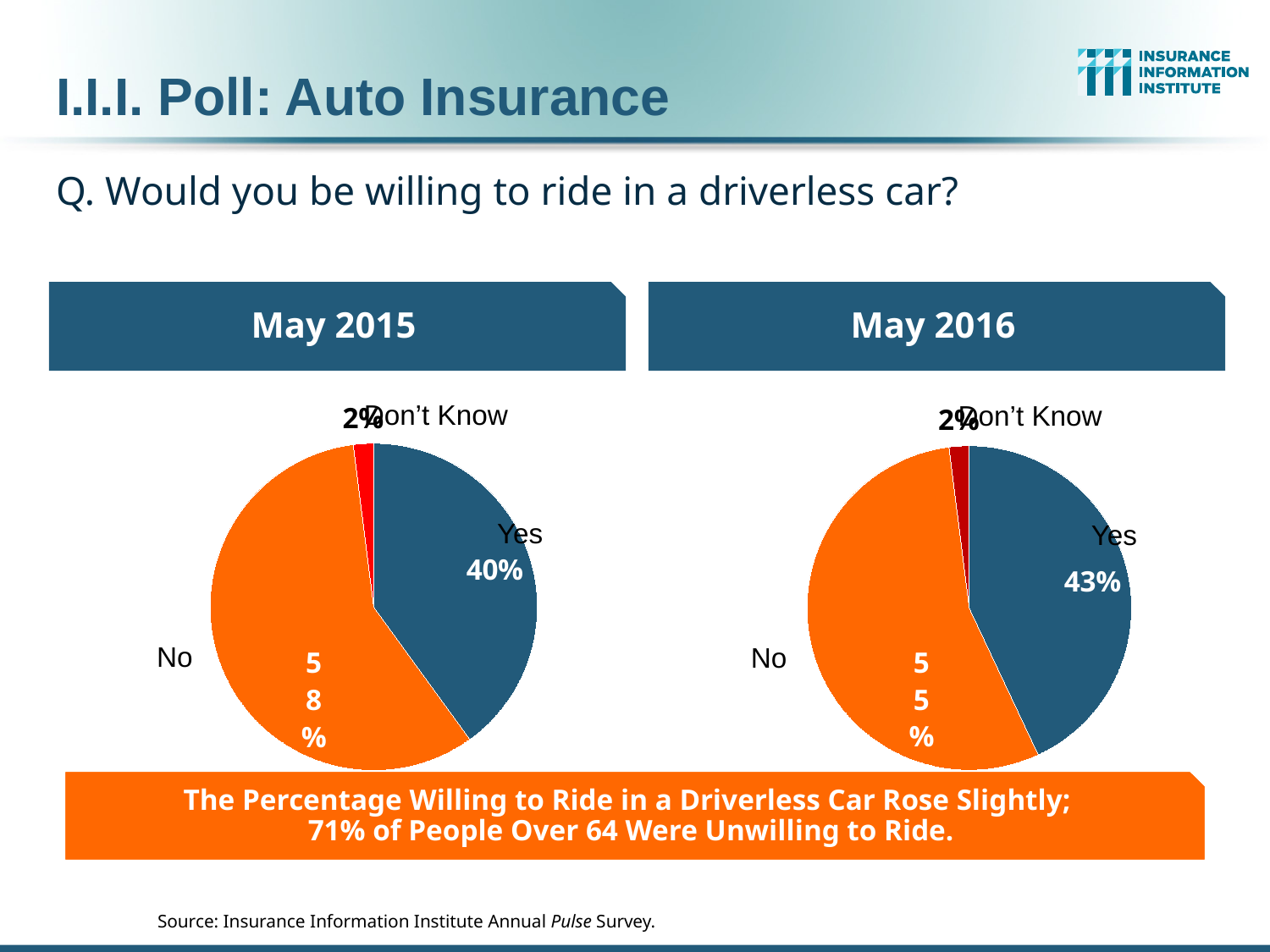
In the May 2015 chart, what percentage answered Yes? 40% What type of chart is used for the May 2016 data? Pie chart In the May 2016 chart, what percentage answered Don't Know? 2% In the May 2016 chart, what percentage answered No? 55% In the May 2015 chart, what percentage answered No? 58% In the May 2015 chart, which response has the largest share? No In the May 2016 chart, which response has the smallest share? Don't Know How many slices does the May 2015 pie chart have? 3 Which chart shows a larger Yes percentage, May 2015 or May 2016? May 2016 What colour is the No slice in the May 2015 chart? Orange In the May 2016 chart, what percentage answered Yes? 43% In the May 2016 chart, what is the difference between the No and Yes percentages? 12%